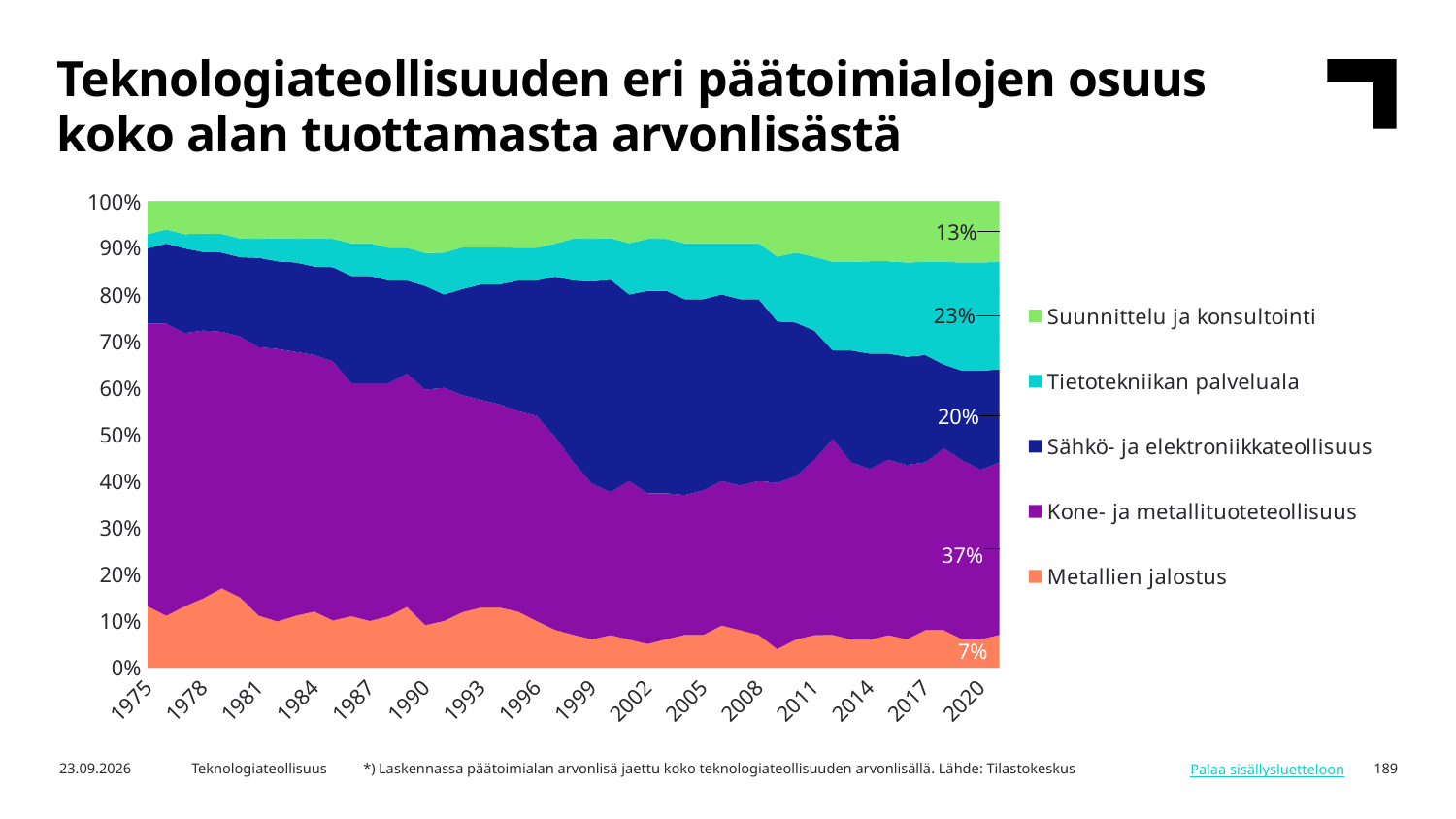
What kind of chart is shown on the slide? Area chart How many series does the legend list? 5 What is the share of Tietotekniikan palveluala in 2020? 23% What is the share of Suunnittelu ja konsultointi in 2020? 13% Which sector has the smallest share in 2020? Metallien jalostus Which colour represents Metallien jalostus in the chart? Orange Which sector has the largest share in 2020? Kone- ja metallituoteteollisuus In 2020, which is larger: the share of Tietotekniikan palveluala or Sähkö- ja elektroniikkateollisuus? Tietotekniikan palveluala What is the difference in percentage points between the 2020 shares of Kone- ja metallituoteteollisuus and Metallien jalostus? 30 percentage points Does the share of Kone- ja metallituoteteollisuus rise or fall from 1975 to 2020? Fall